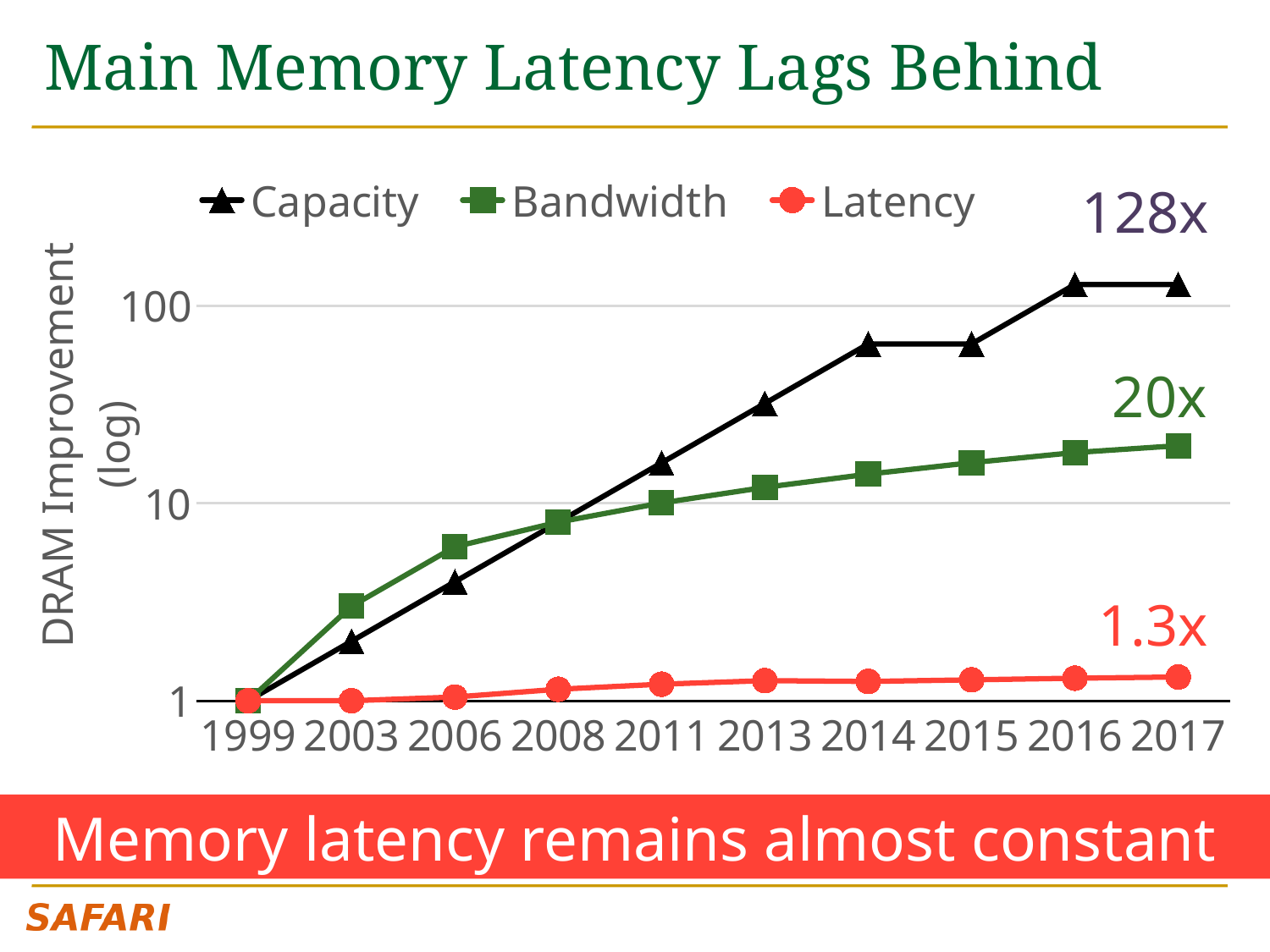
What kind of chart is shown on the slide? line chart Which series has the lowest value in 2017? Latency What is the DRAM bandwidth improvement in 2017? 20x What is the DRAM latency improvement in 2017? 1.3x Does the Capacity series rise or fall from 1999 to 2017? rise What is the DRAM capacity improvement in 2017? 128x How many series does the legend list? 3 Which series has the highest value in 2017? Capacity In 2006, which is larger, Bandwidth or Capacity? Bandwidth What is the label on the y axis? DRAM Improvement (log) How many years are shown on the x axis? 10 Is the Capacity value for 2016 greater or less than 100? greater